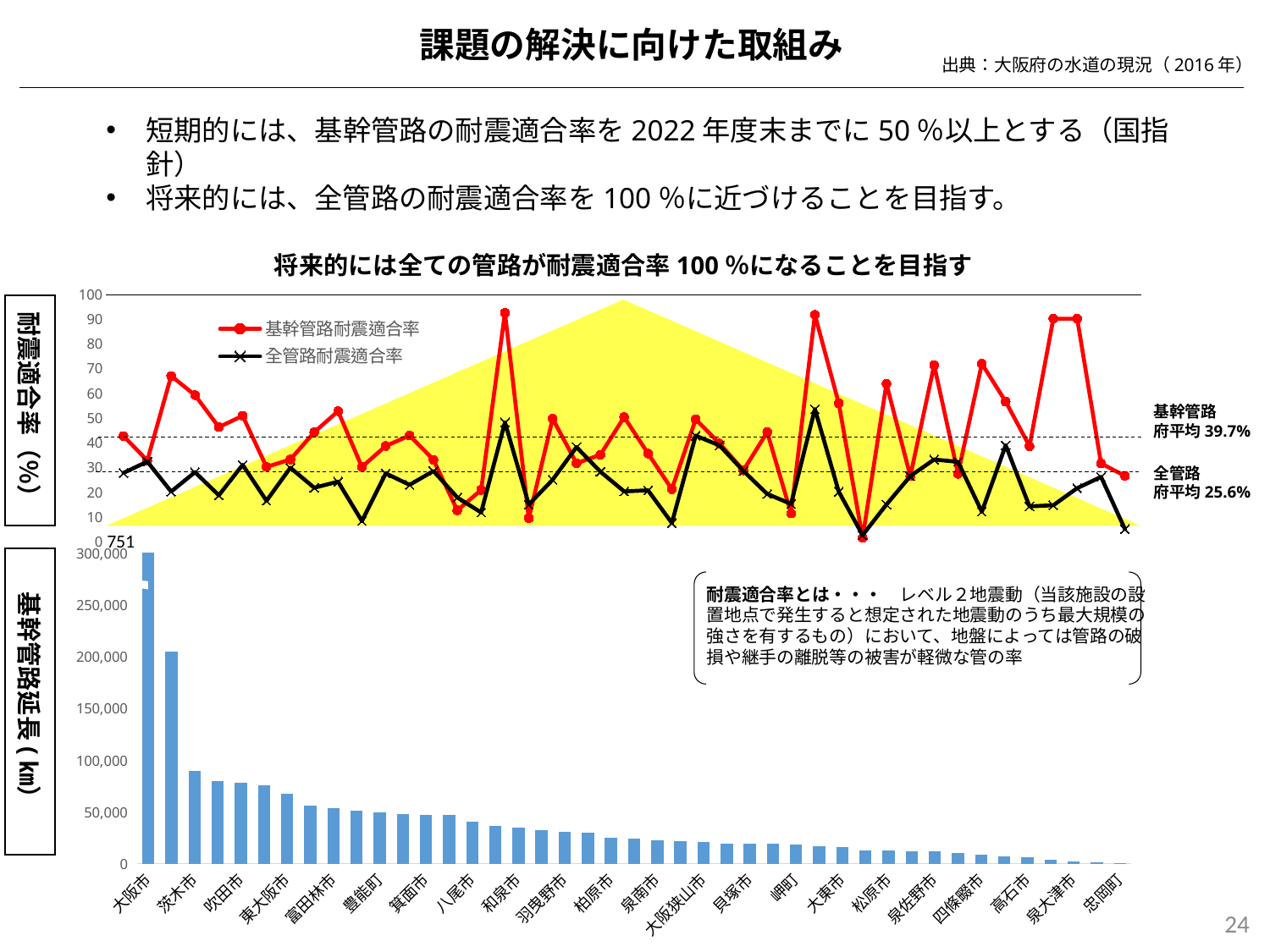
In the top chart (耐震適合率), what is the 府平均 value for 全管路? 25.6% In the bottom chart (基幹管路延長), which municipality has the highest value? 大阪市 What kind of chart is the top chart showing 耐震適合率 (%)? line chart What kind of chart is the bottom chart showing 基幹管路延長 (km)? bar chart In the top chart (耐震適合率), what is the 府平均 value for 基幹管路? 39.7% In the bottom chart (基幹管路延長), which is larger, 茨木市 or 吹田市? 茨木市 In the top chart (耐震適合率), which 府平均 is higher, 基幹管路 or 全管路? 基幹管路 In the top chart (耐震適合率), what are the two series named in the legend? 基幹管路耐震適合率 and 全管路耐震適合率 In the top chart (耐震適合率), how many series does the legend list? 2 In the top chart (耐震適合率), what is the difference between the 基幹管路 府平均 and the 全管路 府平均? 14.1 percentage points In the bottom chart (基幹管路延長), do the values rise or fall from left to right along the x axis? fall In the bottom chart (基幹管路延長), is the value for 吹田市 greater or less than 100,000? less